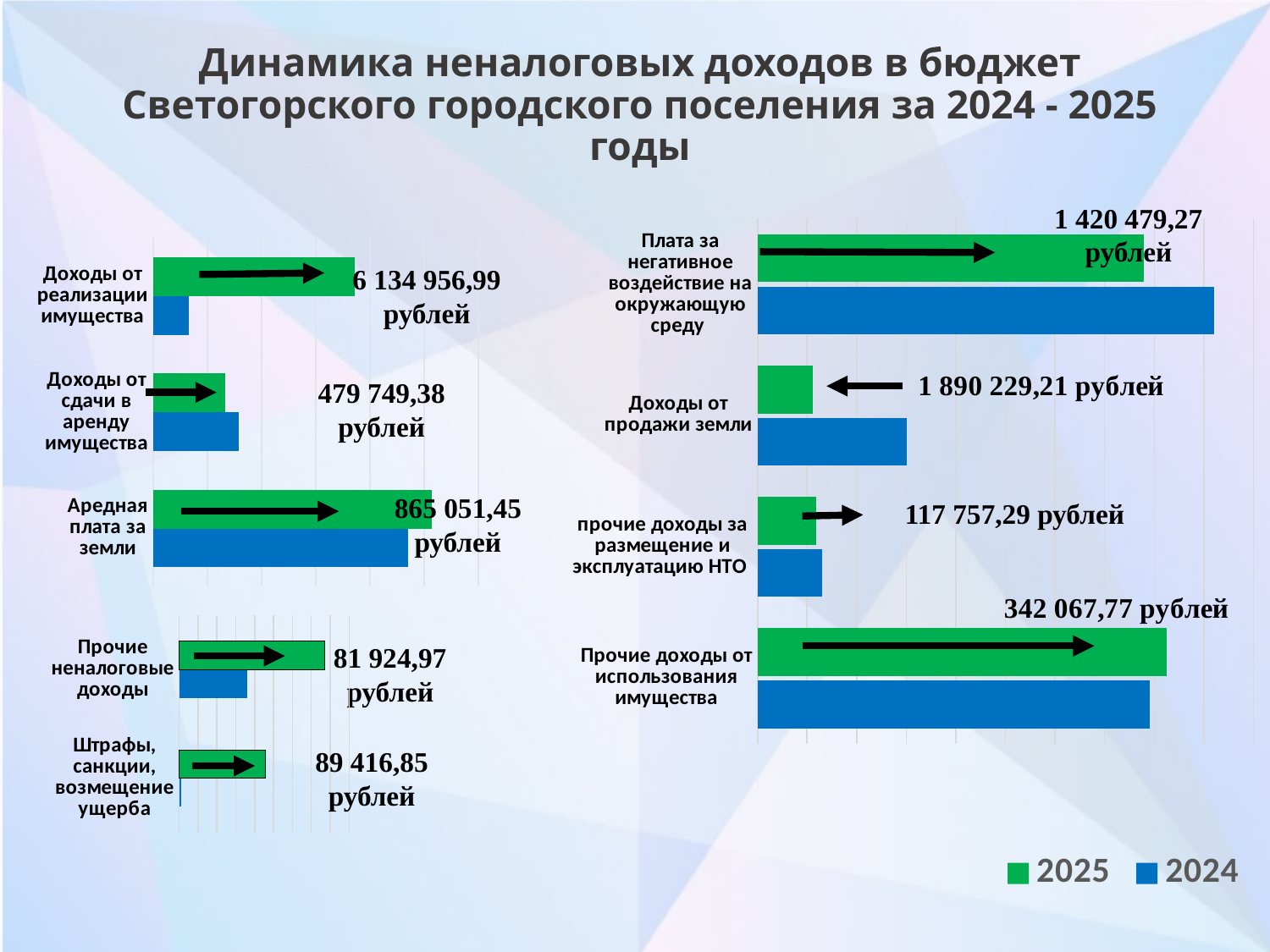
How many revenue categories are shown in the right column of charts? 4 For 'Доходы от продажи земли', which year has the longer bar, 2025 or 2024? 2024 What colour represents 2025 in the legend? green What kind of chart is used on this slide to show the non-tax revenues? bar chart For 'Доходы от реализации имущества', which year has the longer bar, 2025 or 2024? 2025 For 'Штрафы, санкции, возмещение ущерба', which year has the longer bar, 2025 or 2024? 2025 How many revenue categories are shown on the slide in total? 9 How many series does the legend list? 2 How many revenue categories are shown in the left column of charts? 5 Which years are listed in the legend? 2025 and 2024